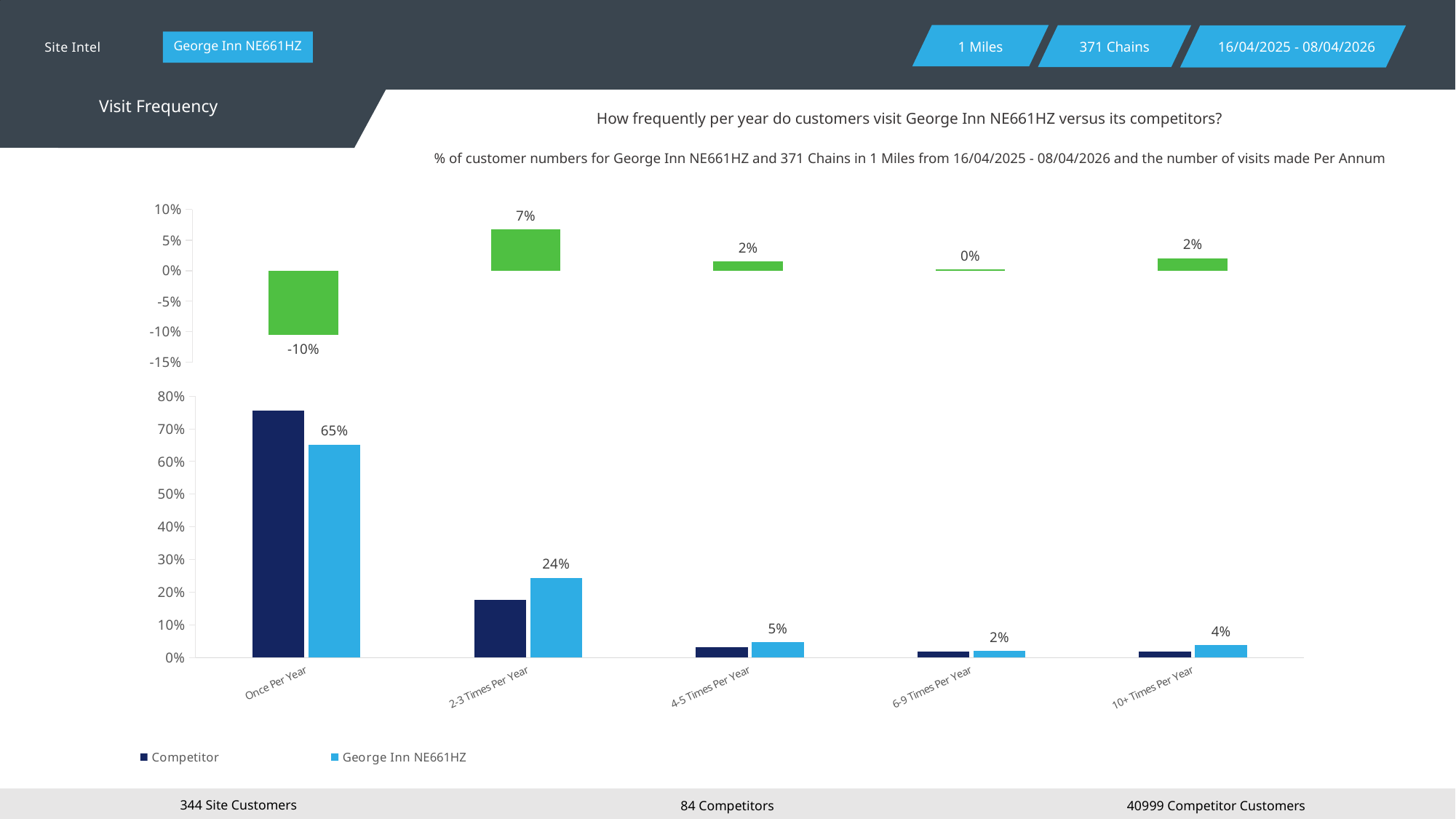
In the bottom bar chart, is the Competitor value for Once Per Year greater or less than 70%? greater How many series does the legend of the bottom bar chart list? 2 In the top green chart, what is the value for 2-3 Times Per Year? 7% In the bottom bar chart, which category has the highest value for George Inn NE661HZ? Once Per Year In the bottom bar chart, what is the difference between the George Inn NE661HZ values for Once Per Year and 2-3 Times Per Year? 41% In the bottom bar chart, for Once Per Year, which is larger: the Competitor bar or the George Inn NE661HZ bar? Competitor In the top green chart, which category has the lowest value? Once Per Year In the bottom bar chart, what is the value for George Inn NE661HZ for Once Per Year? 65% In the top green chart, what is the value for Once Per Year? -10% In the bottom bar chart, what is the value for George Inn NE661HZ for 10+ Times Per Year? 4% In the bottom bar chart, is the Competitor value for 2-3 Times Per Year greater or less than 20%? less In the bottom bar chart, what is the value for George Inn NE661HZ for 2-3 Times Per Year? 24%